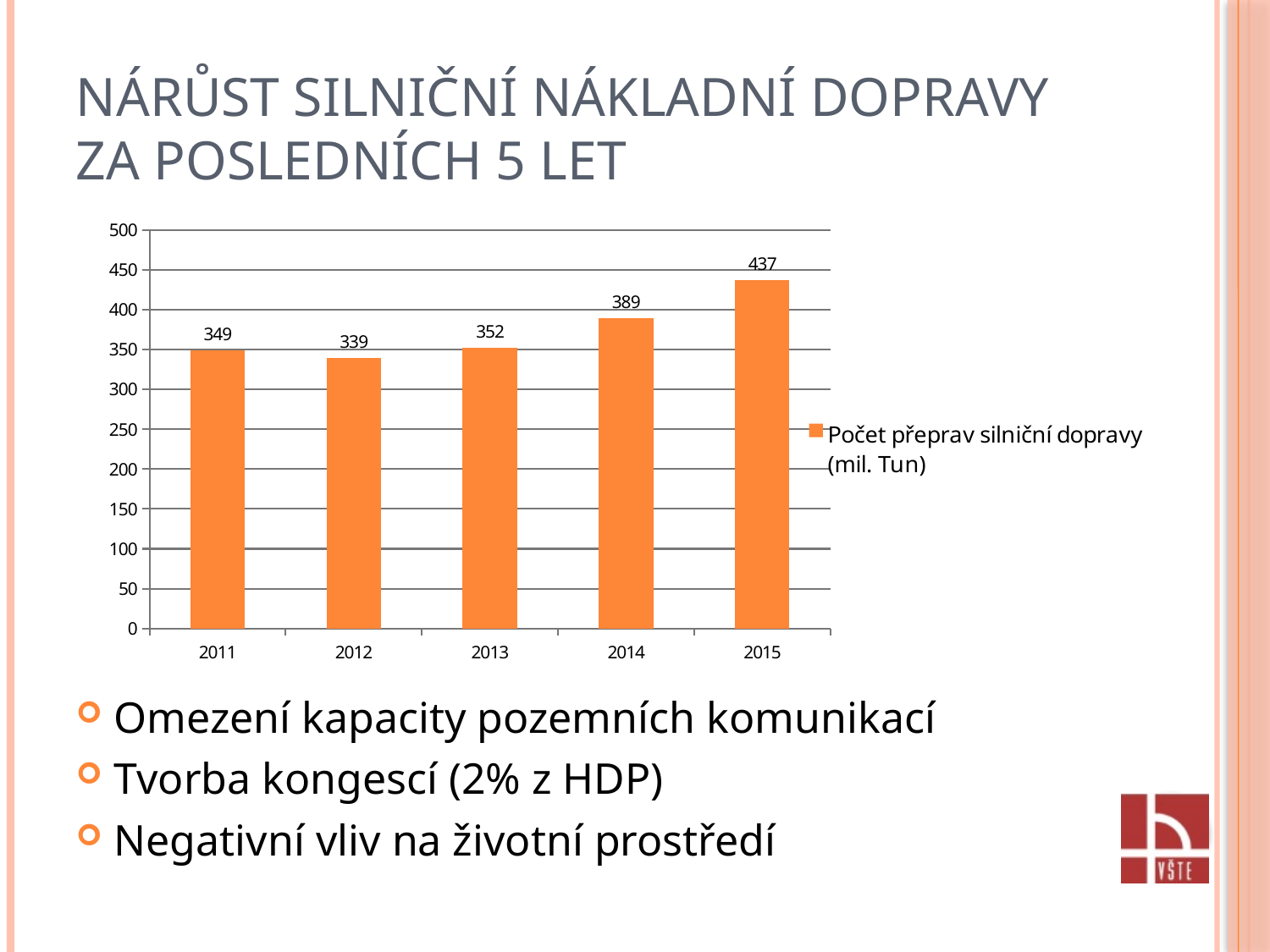
Which year has the lowest value? 2012 What is the value for 2015? 437 What kind of chart is shown on the slide? bar chart What is the value for 2013? 352 Which year has the highest value? 2015 What is the value for 2011? 349 What is the difference between the values for 2015 and 2014? 48 What is the difference between the values for 2011 and 2012? 10 How many years are shown on the x axis? 5 Is the value for 2014 greater or less than 400? less What is the legend entry for the series shown? Počet přeprav silniční dopravy (mil. Tun) Which is larger, the value for 2014 or the value for 2013? 2014